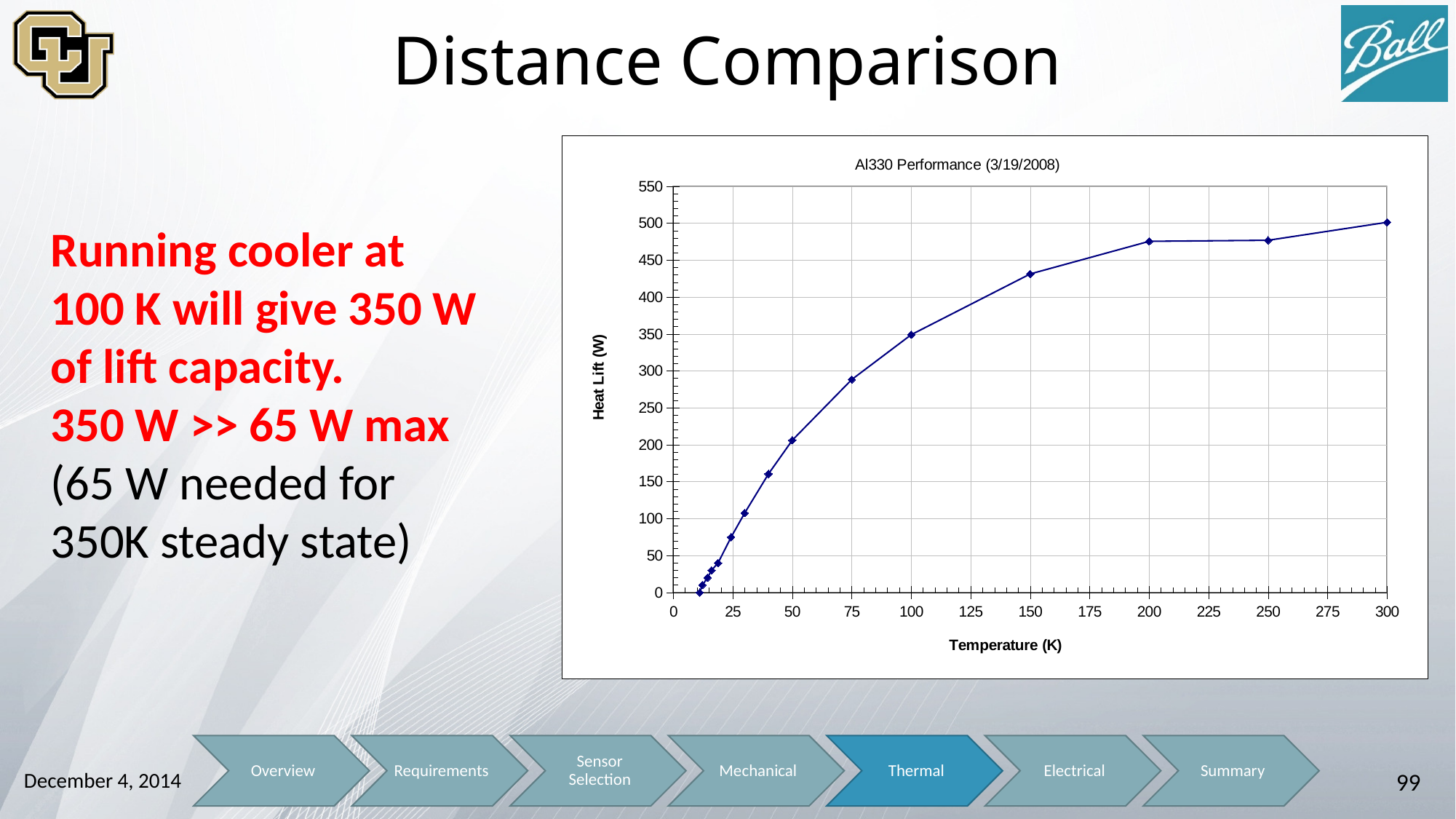
Which has the larger heat lift, 150 K or 100 K? 150 K What is the title of the chart? Al330 Performance (3/19/2008) Is the heat lift at 200 K greater or less than 450? greater Is the heat lift at 50 K greater or less than 250? less At which temperature is the heat lift highest? 300 K Is the heat lift at 25 K greater or less than 100? less What is the label of the y axis of the chart? Heat Lift (W) What kind of chart is shown on the slide? line chart What is the heat lift at a temperature of 100 K? 350 Does the heat lift rise or fall as temperature increases along the x axis? rise